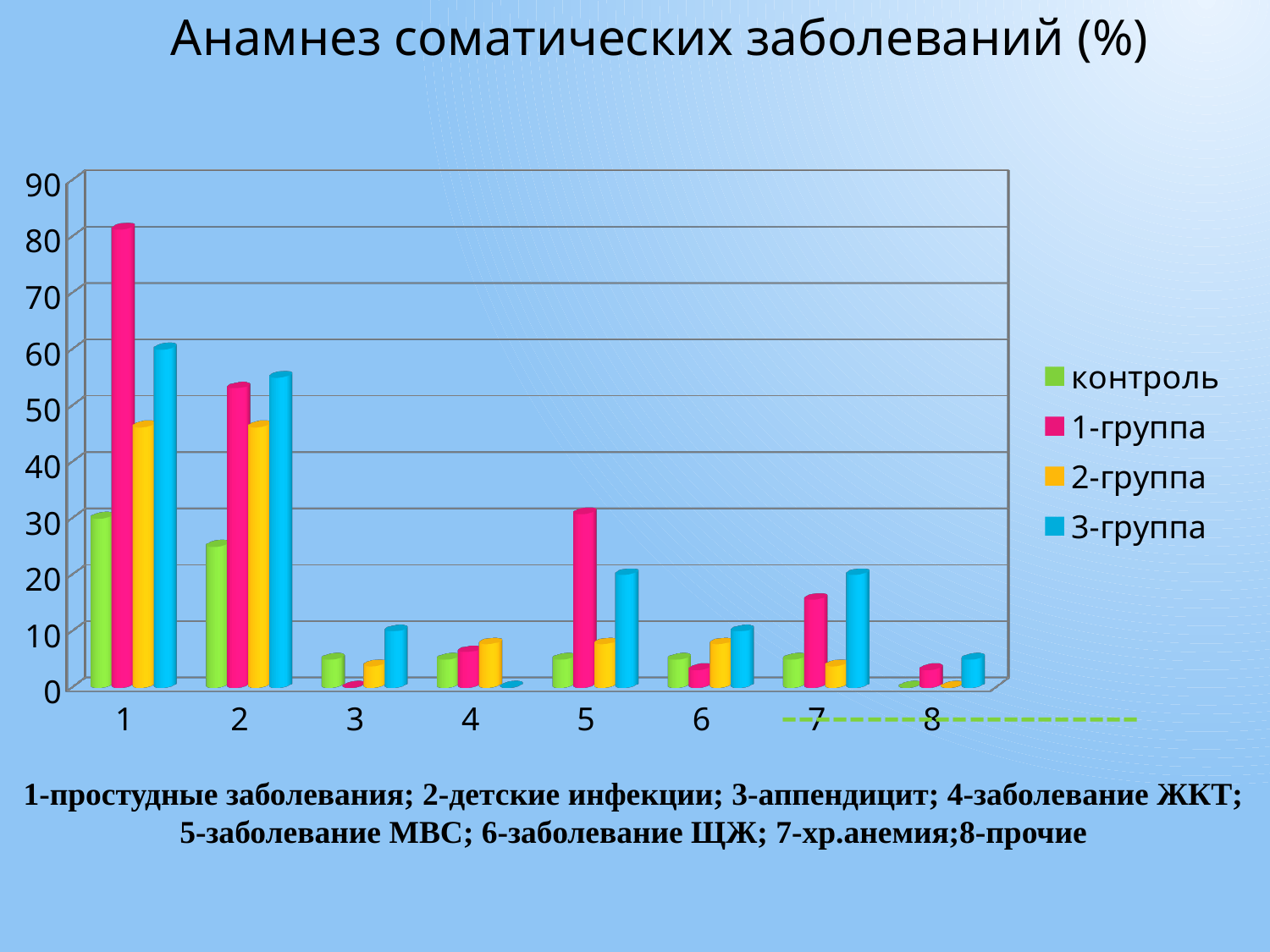
Which category has the highest value for the 1-группа series? 1 How many series does the legend list? 4 Is the value for контроль in category 1 greater or less than 40? less Is the value for 1-группа in category 1 greater or less than 70? greater What kind of chart is shown on the slide? bar chart In category 7, which series has the highest value? 3-группа Is the value for 3-группа in category 1 greater or less than 50? greater What is the title of the chart? Анамнез соматических заболеваний (%) In category 1, which is larger: 1-группа or 3-группа? 1-группа In category 5, which is larger: 1-группа or 3-группа? 1-группа How many categories are shown on the x axis? 8